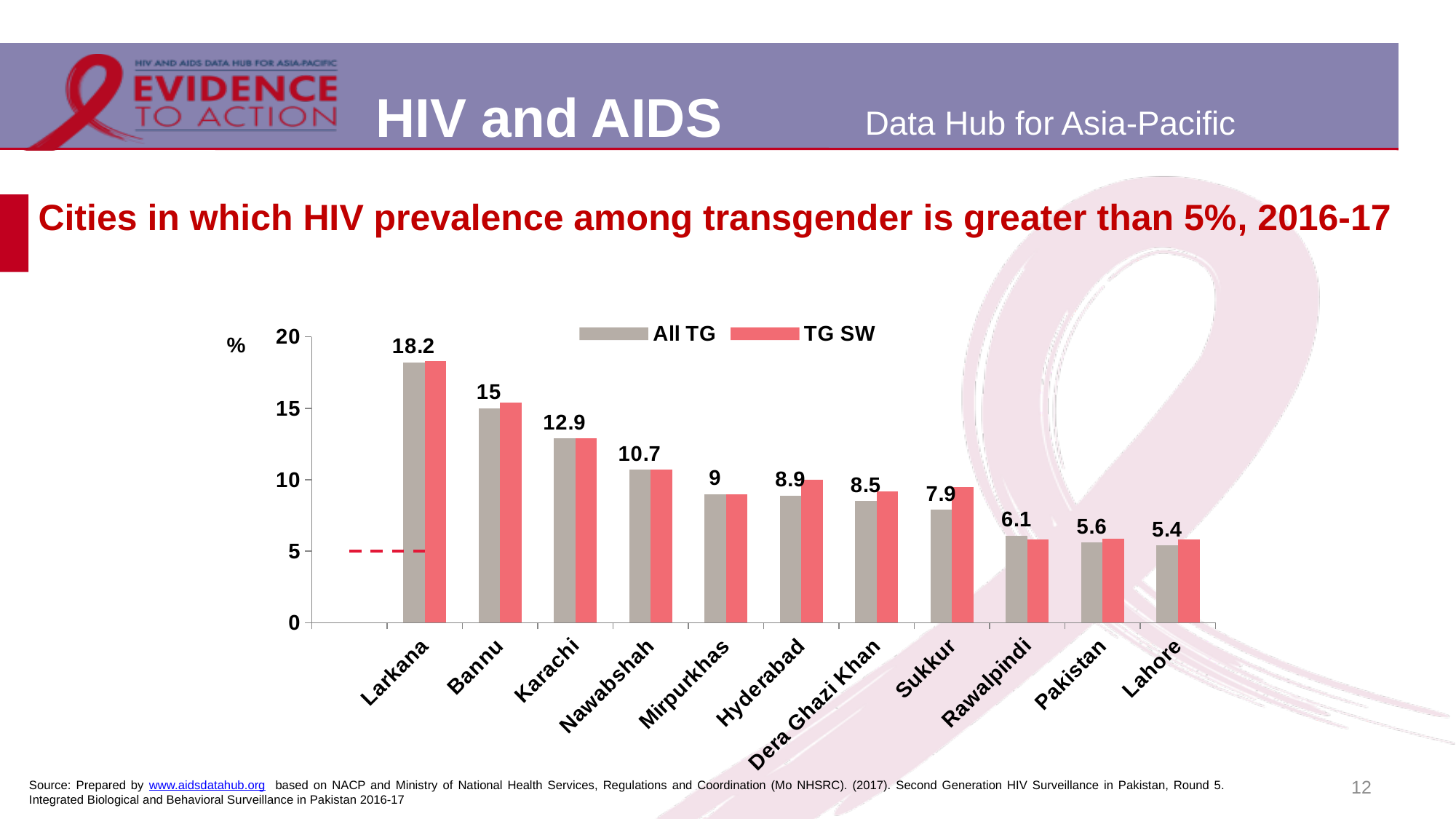
Which city has the highest All TG HIV prevalence? Larkana How many categories are shown on the x axis? 11 Which has a higher All TG value, Nawabshah or Sukkur? Nawabshah What kind of chart is shown on the slide? Bar chart What is the All TG value shown for Dera Ghazi Khan? 8.5 Is the TG SW value for Sukkur greater or less than 10? less What is the All TG HIV prevalence value for Larkana? 18.2 What is the difference between the All TG values for Larkana and Bannu? 3.2 How many series does the legend list? 2 What is the All TG value shown for Karachi? 12.9 Which category has the lowest All TG value on the chart? Lahore Is the TG SW value for Larkana greater or less than 15? greater